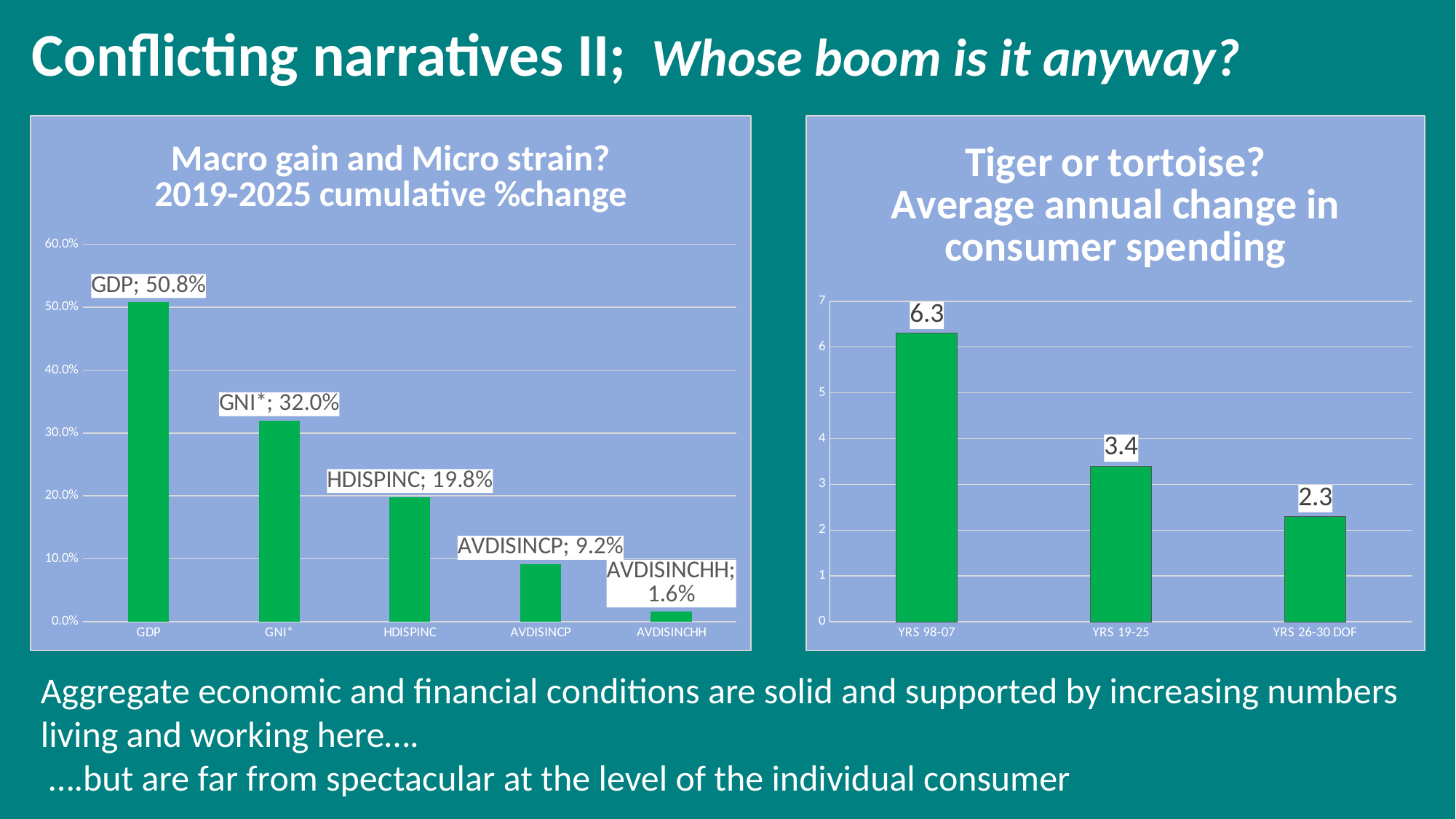
In the 'Tiger or tortoise?' chart, which category has the highest value? YRS 98-07 In the 'Macro gain and Micro strain?' chart, is the value for AVDISINCP greater or less than 10.0%? less What kind of chart is the 'Tiger or tortoise?' chart? bar chart In the 'Tiger or tortoise?' chart, what is the value for YRS 19-25? 3.4 In the 'Macro gain and Micro strain?' chart, what is the value for HDISPINC? 19.8% In the 'Macro gain and Micro strain?' chart, do the values rise or fall from left to right? fall In the 'Macro gain and Micro strain?' chart, how many categories are shown? 5 In the 'Tiger or tortoise?' chart, what is the difference between YRS 98-07 and YRS 26-30 DOF? 4.0 In the 'Macro gain and Micro strain?' chart, what is the value for GDP? 50.8% In the 'Macro gain and Micro strain?' chart, what is the difference between GDP and GNI*? 18.8% In the 'Macro gain and Micro strain?' chart, which category has the lowest value? AVDISINCHH In the 'Tiger or tortoise?' chart, which is larger, YRS 19-25 or YRS 26-30 DOF? YRS 19-25